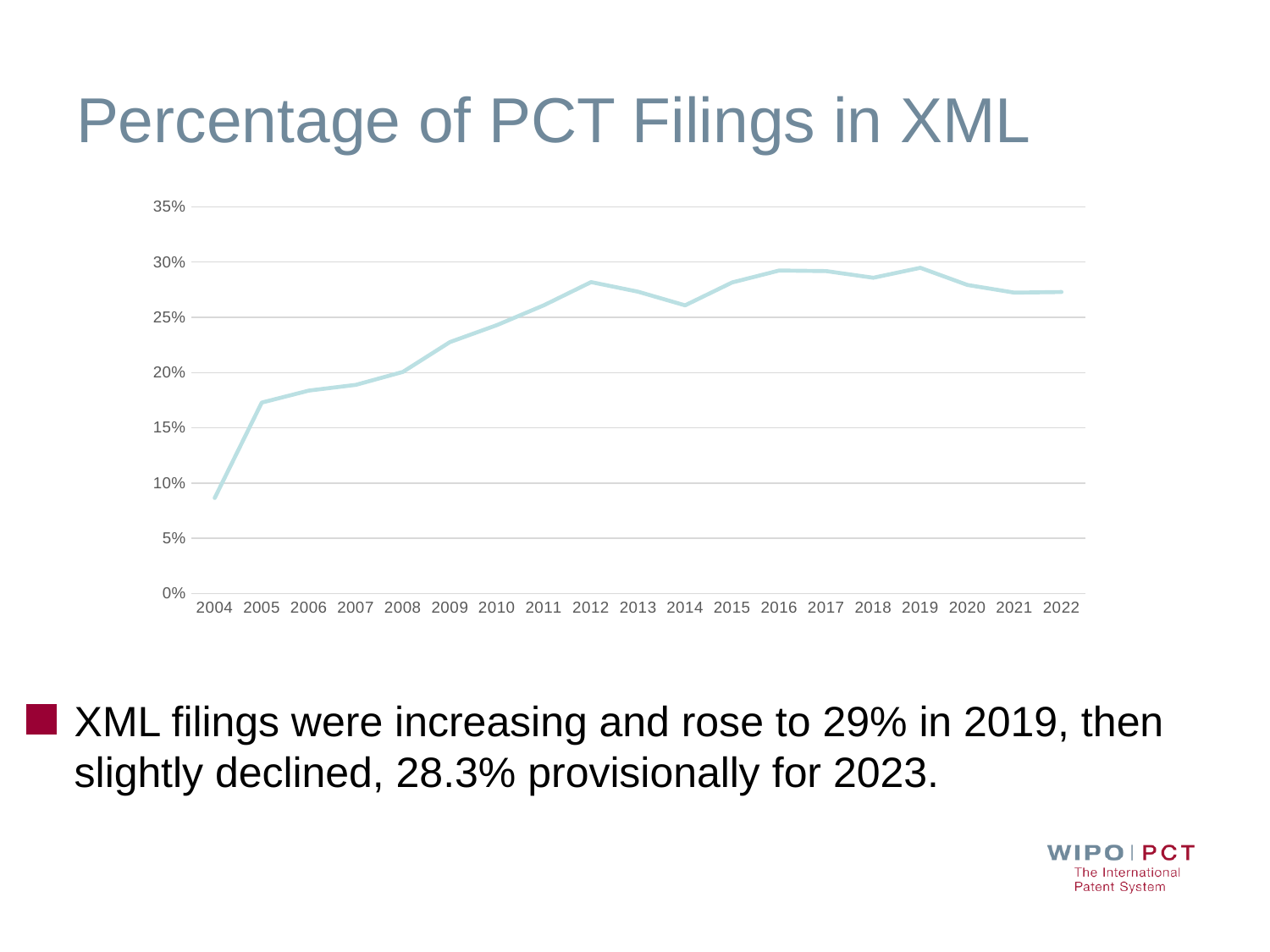
What is the title of the chart? Percentage of PCT Filings in XML Which year has the lowest percentage of PCT filings in XML? 2004 Is the value for 2019 greater or less than 30%? less Is the value for 2009 greater or less than 20%? greater Which year has the larger value, 2012 or 2014? 2012 Is the value for 2005 greater or less than 15%? greater Which year has the larger value, 2010 or 2020? 2020 How many years are plotted on the x axis of the chart? 19 What kind of chart is shown on the slide? line chart Do the values rise or fall from 2004 to 2012? rise